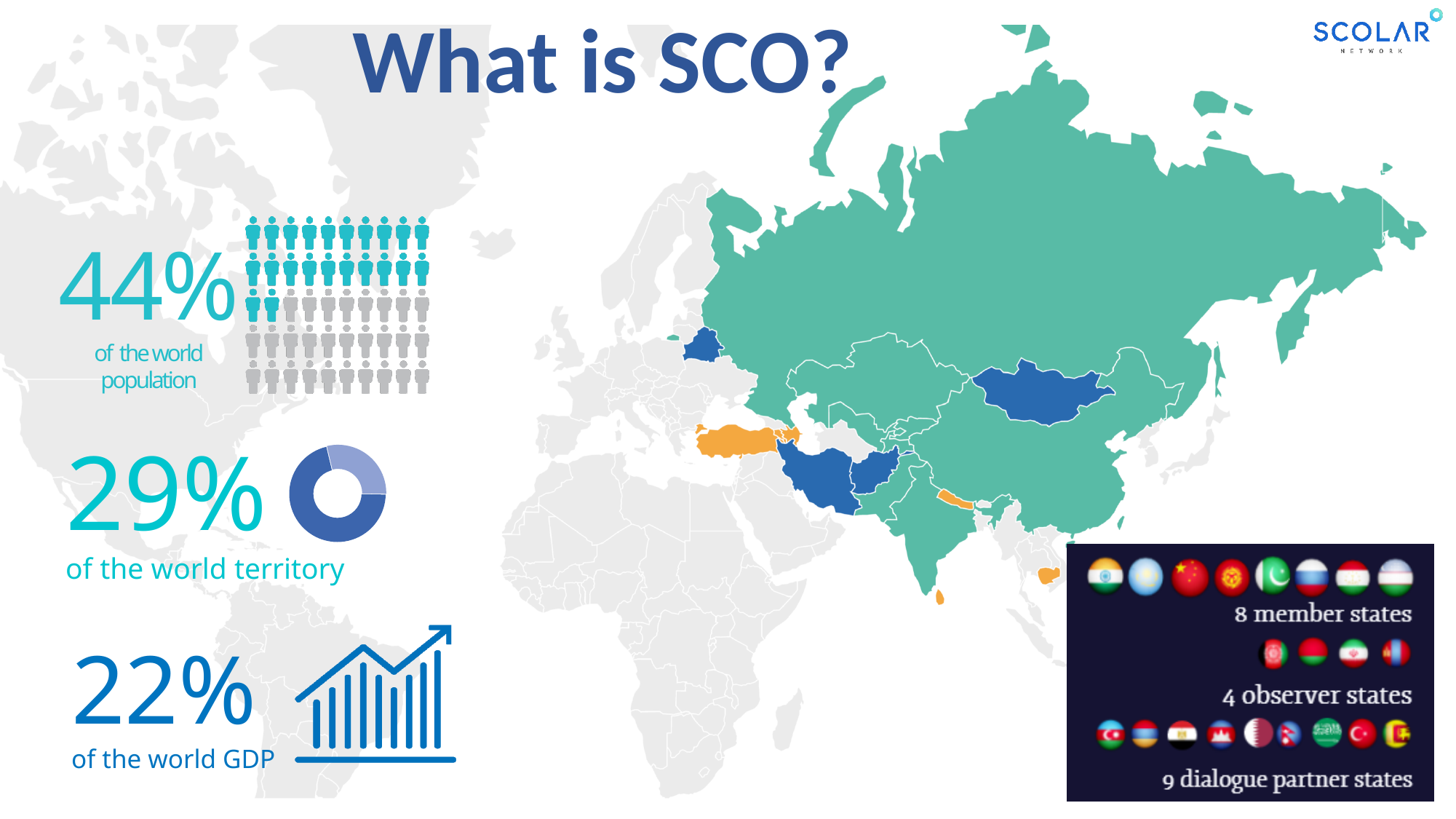
What share of the world GDP does the SCO account for, according to the slide? 22% Of the three percentages shown on the left of the slide (population, territory, GDP), which is the highest? World population (44%) Of the three percentages shown on the left of the slide (population, territory, GDP), which is the lowest? World GDP (22%) What is the difference between the SCO's share of world population and its share of world GDP? 22% Which is larger: the SCO's share of world territory or its share of world GDP? World territory (29%) What share of the world territory does the SCO account for, as shown by the donut chart? 29% How many observer states does the SCO have, according to the slide? 4 What is the difference between the SCO's share of world population and its share of world territory? 15% According to the slide, what share of the world population does the SCO account for? 44% How many member states does the SCO have, according to the slide? 8 How many dialogue partner states does the SCO have, according to the slide? 9 What kind of chart is used to illustrate the 29% of the world territory figure? Pie (donut) chart